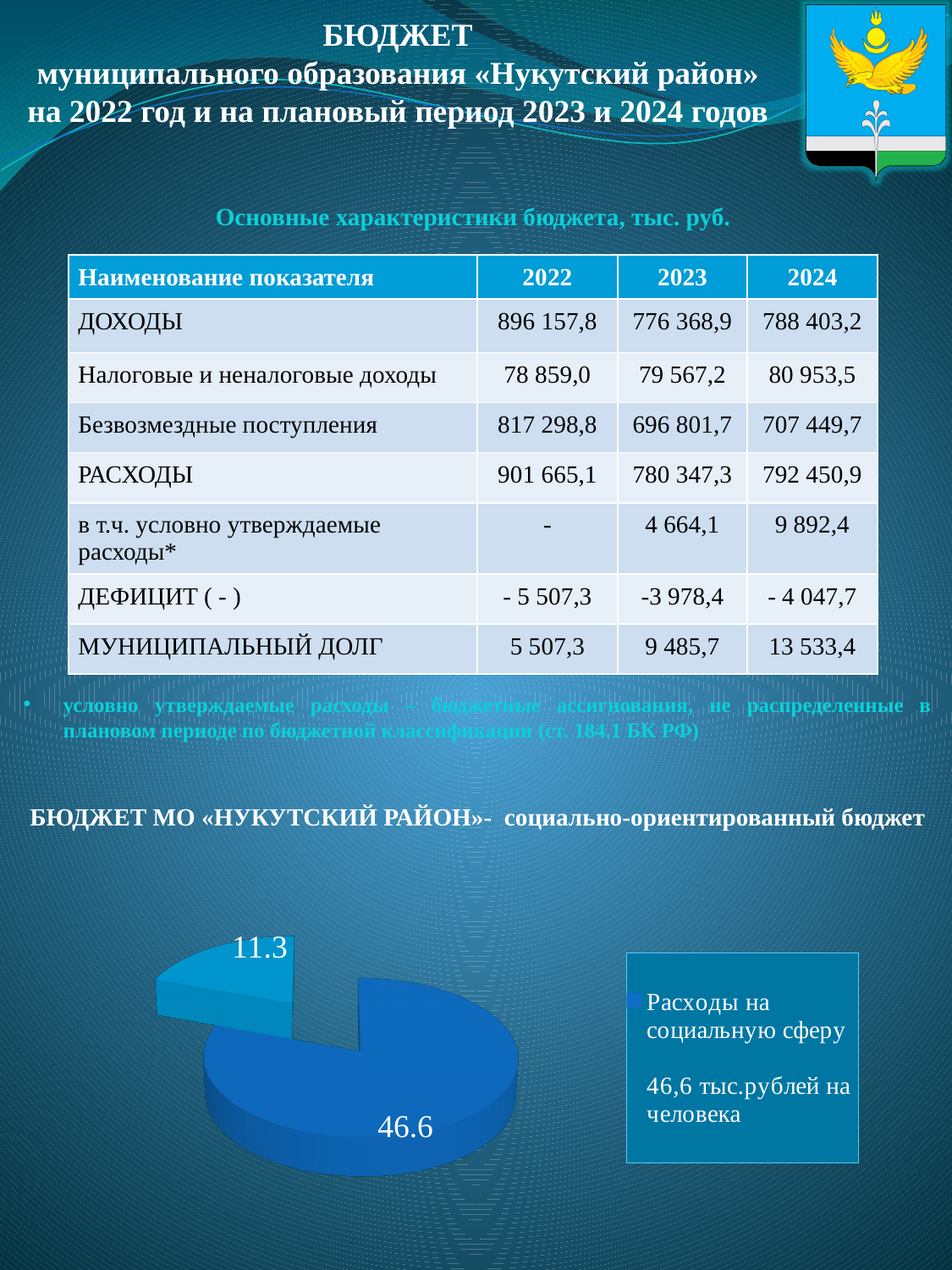
What is the value of the largest slice in the pie chart? 46.6 Which slice of the pie chart is pulled out (exploded) from the rest? 11.3 In the pie chart, what is the value of the slice for "Расходы на социальную сферу"? 46.6 What kind of chart is shown at the bottom of the slide? pie chart What is the value of the smallest slice in the pie chart? 11.3 In the pie chart, which slice is larger: the one labelled 46.6 or the one labelled 11.3? 46.6 What is the difference between the two slice values in the pie chart (46.6 and 11.3)? 35.3 How many slices does the pie chart have? 2 What legend entry is shown next to the pie chart? Расходы на социальную сферу 46,6 тыс.рублей на человека